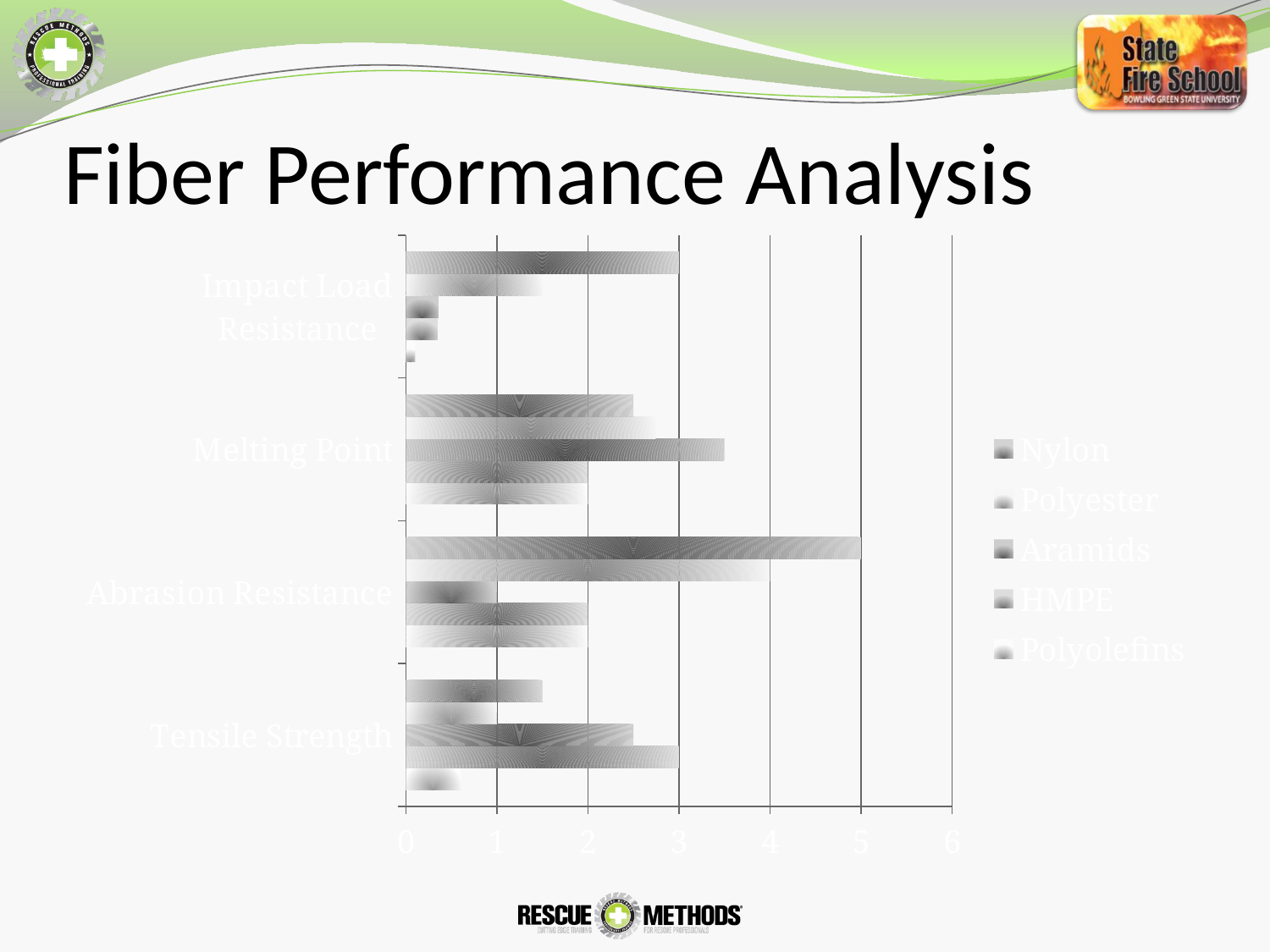
Which is larger: the longest bar for Abrasion Resistance or the longest bar for Tensile Strength? Abrasion Resistance Which fibers are listed in the chart's legend? Nylon, Polyester, Aramids, HMPE, Polyolefins What value does the longest bar in the Impact Load Resistance category reach? 3 How many categories are shown on the chart's vertical axis? 4 How many series does the chart's legend list? 5 What kind of chart is shown on the slide? bar chart Which category contains the longest bar on the chart? Abrasion Resistance Is the longest bar in the Melting Point category greater or less than 3? greater Is the longest bar in the Tensile Strength category greater or less than 4? less What is the title of the slide containing the chart? Fiber Performance Analysis What value does the longest bar in the Abrasion Resistance category reach? 5 Is the shortest bar in the Impact Load Resistance category greater or less than 1? less